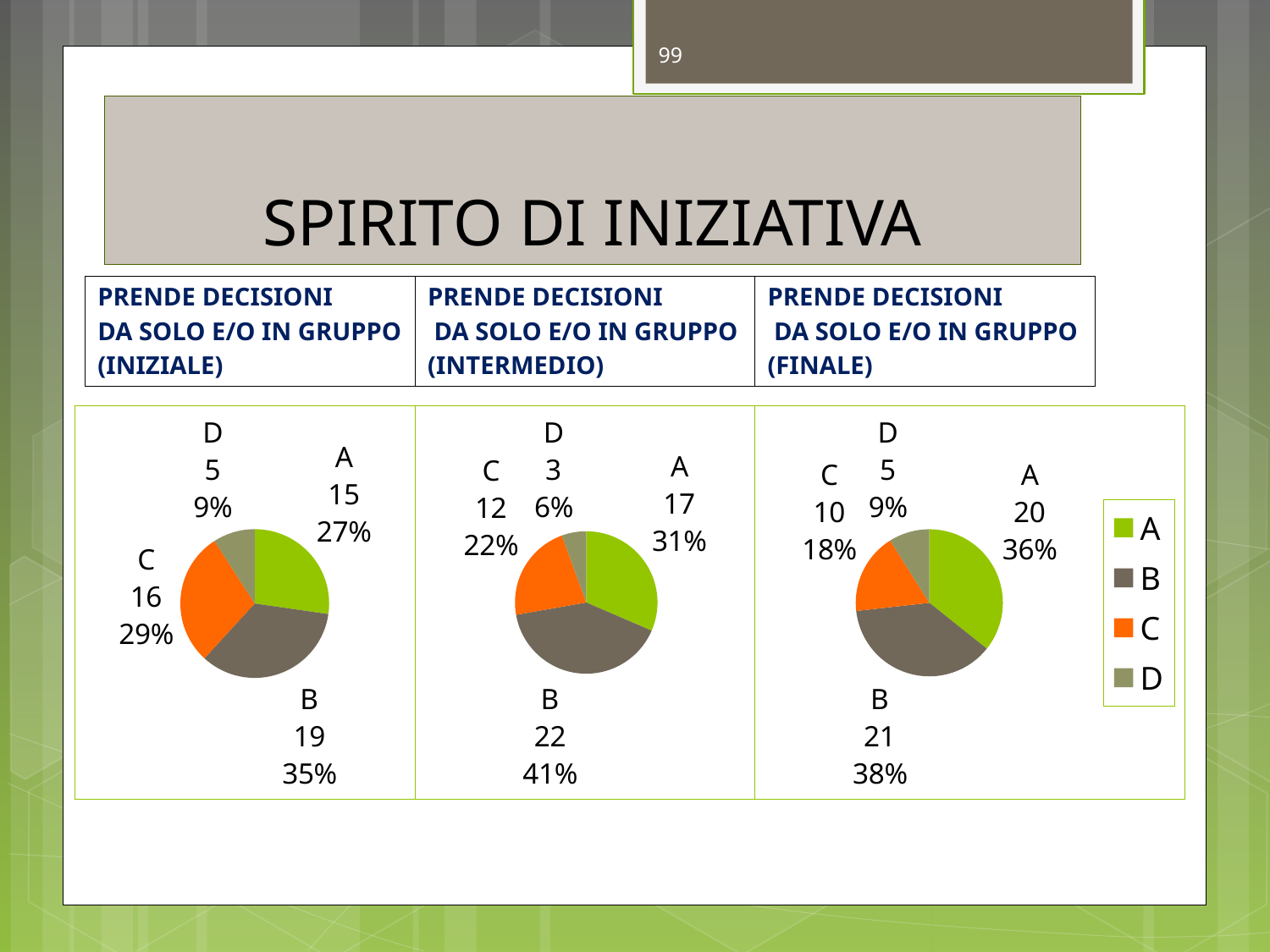
What type of chart is used for the INTERMEDIO data (middle)? Pie chart In the FINALE pie chart (right), what is the difference between the values for B and A? 1 How many categories does the FINALE pie chart (right) show? 4 In the INIZIALE pie chart (left), what is the value for category B? 19 In the FINALE pie chart (right), what is the value for category A? 20 In the INIZIALE pie chart (left), which category has the largest slice? B In the INTERMEDIO pie chart (middle), which category has the smallest slice? D What colour represents category C in the legend? Orange In the FINALE pie chart (right), what percentage share does category D have? 9% In the INTERMEDIO pie chart (middle), what percentage share does category C have? 22% In the INIZIALE pie chart (left), which is larger, the value for A or the value for C? C In the INTERMEDIO pie chart (middle), what is the total of all four category values? 54